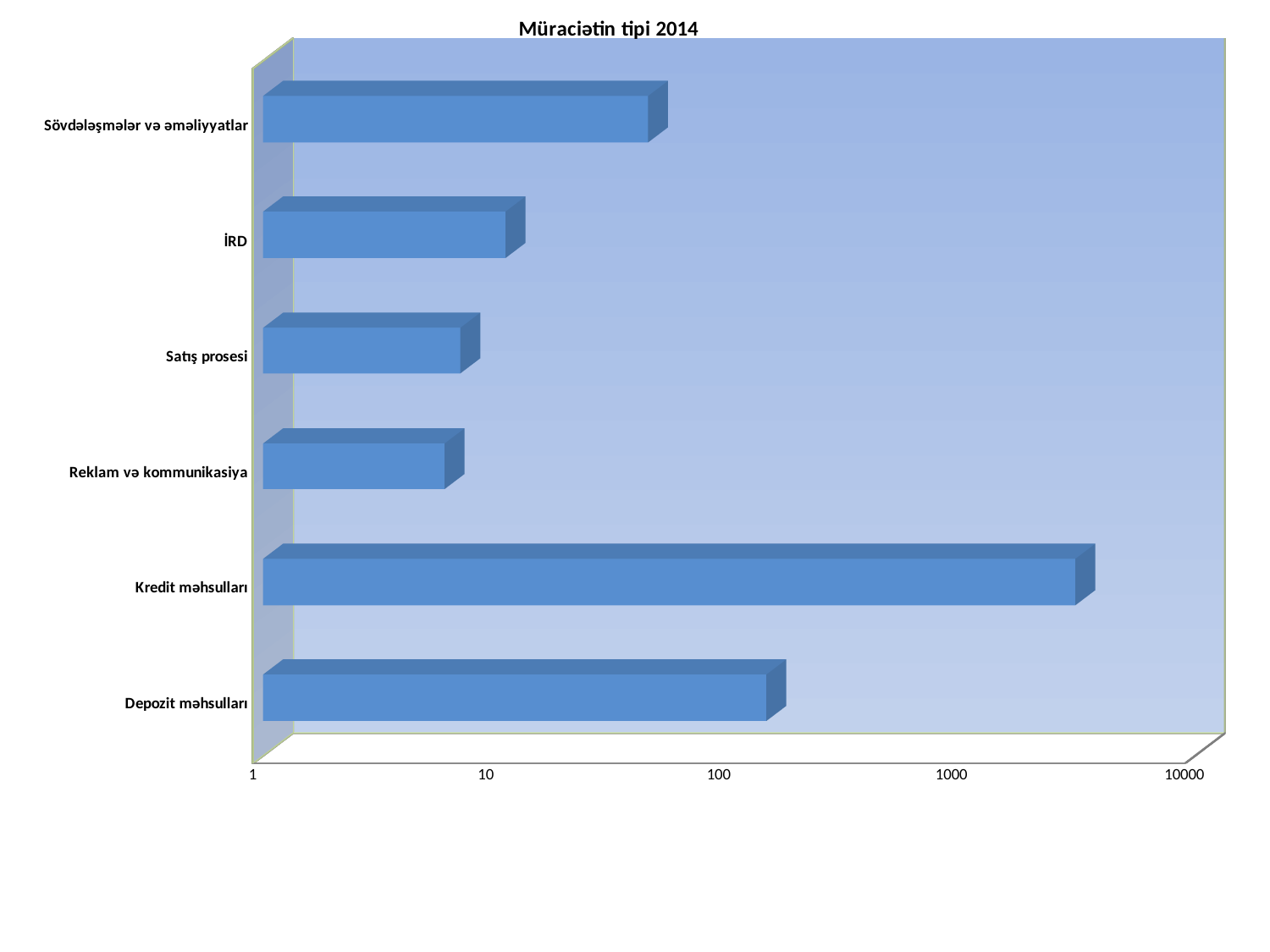
Is the value for Depozit məhsulları greater or less than 100? greater What is the title of the chart? Müraciətin tipi 2014 Is the value for Sövdələşmələr və əməliyyatlar greater or less than 100? less How many categories are plotted in the chart? 6 Is the value for Kredit məhsulları greater or less than 1000? greater Which category has the highest value? Kredit məhsulları Which is larger, the value for İRD or the value for Satış prosesi? İRD What type of chart is shown on the slide? bar chart What is the largest tick value shown on the horizontal axis? 10000 Which is larger, the value for Depozit məhsulları or the value for Sövdələşmələr və əməliyyatlar? Depozit məhsulları